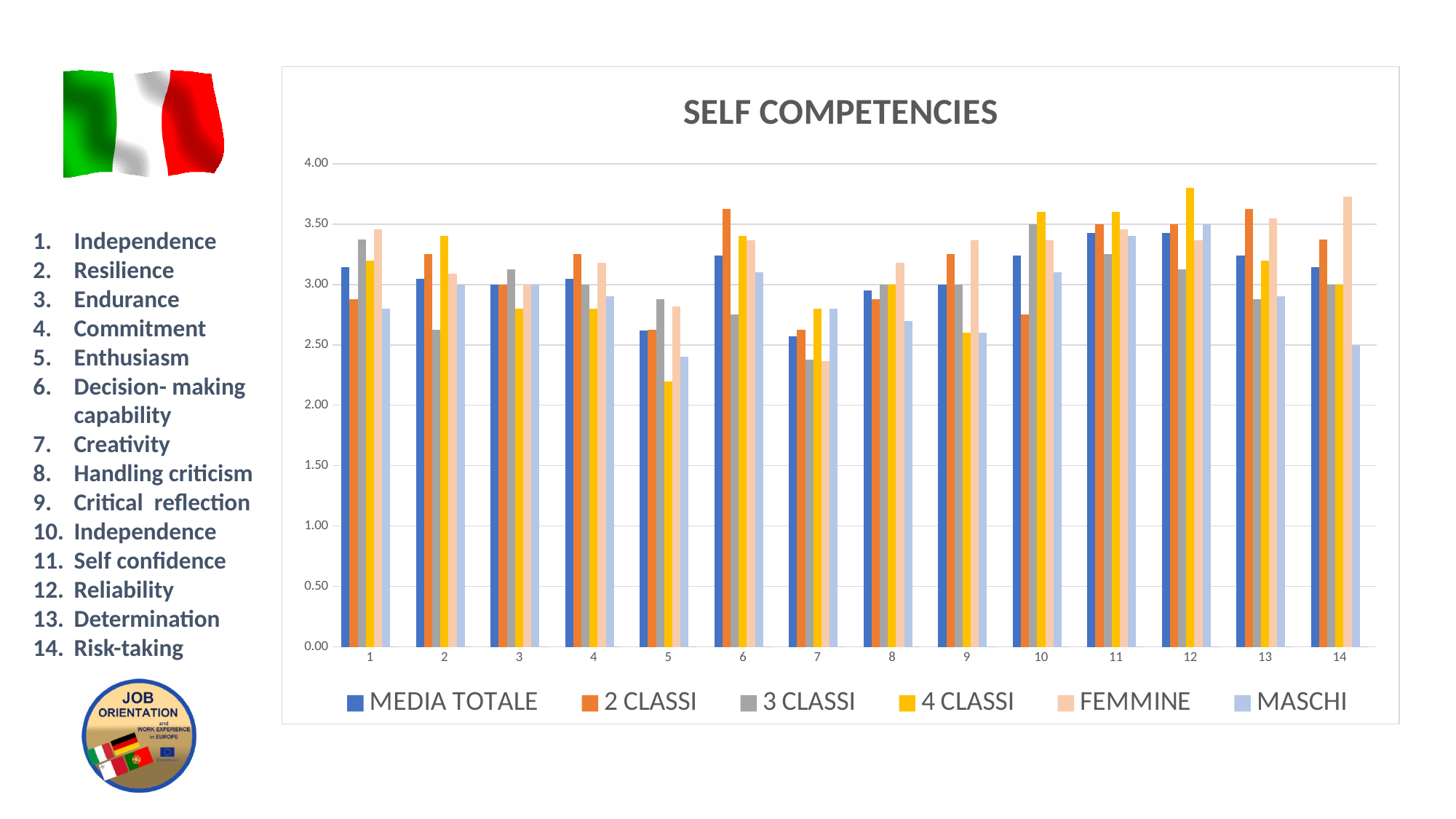
Is the value of FEMMINE for category 14 greater or less than 3.50? greater Is the value of 3 CLASSI for category 7 greater or less than 2.50? less For which category is the 4 CLASSI value lowest? 5 For which category is the FEMMINE value highest? 14 For category 14, which is larger, the FEMMINE value or the MASCHI value? FEMMINE What kind of chart is shown on the slide? bar chart Is the value of 4 CLASSI for category 5 greater or less than 2.50? less Which series is shown in yellow in the legend? 4 CLASSI What is the title of the chart? SELF COMPETENCIES How many series does the legend list? 6 How many categories are shown along the x axis? 14